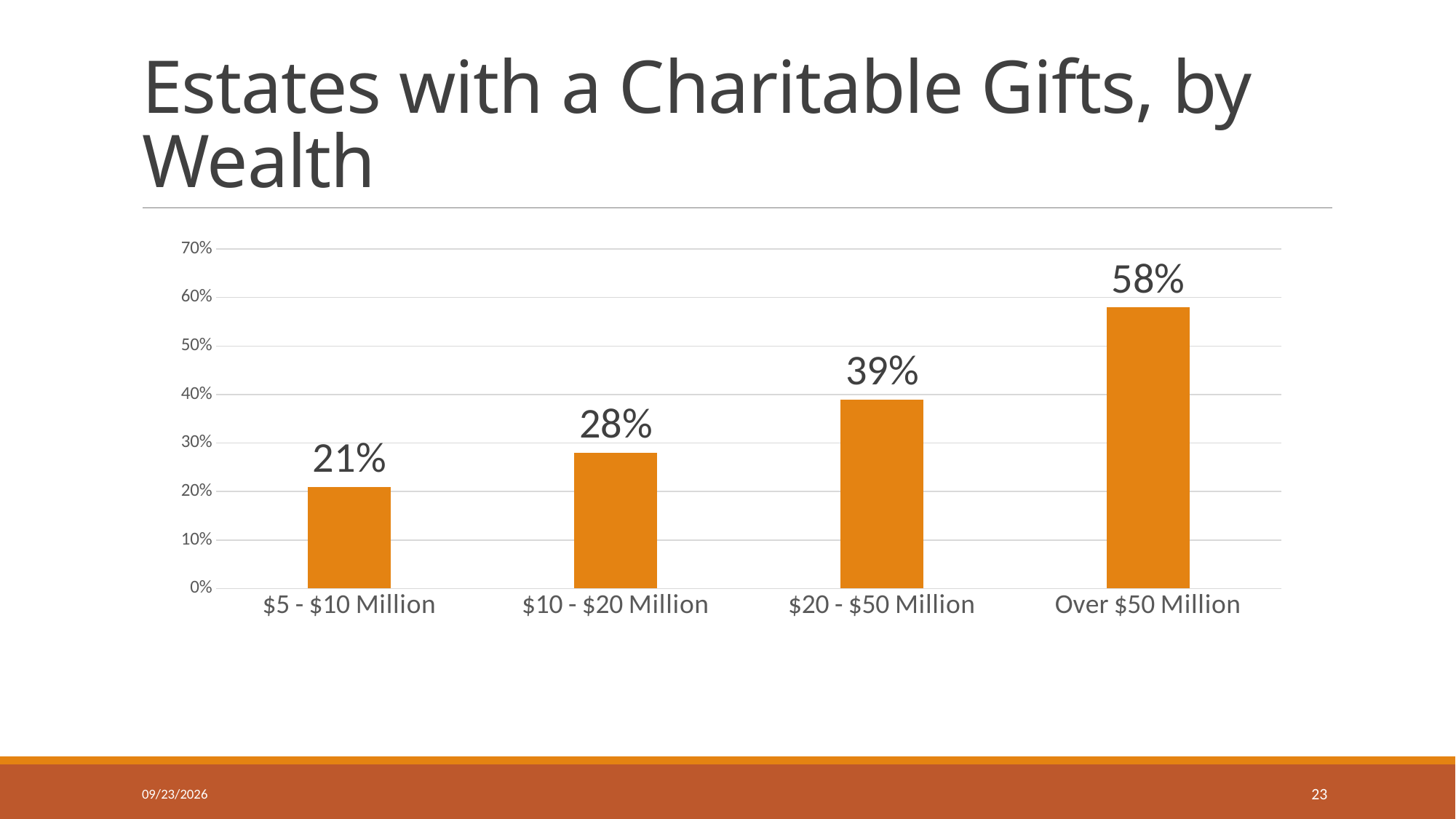
What is the value for Over $50 Million? 58% How many wealth categories are shown on the chart? 4 What is the value for $10 - $20 Million? 28% What is the difference between the values for $20 - $50 Million and $10 - $20 Million? 11% Which is larger, the value for $10 - $20 Million or the value for $20 - $50 Million? $20 - $50 Million Do the values rise or fall as wealth increases along the x axis? Rise What is the difference between the values for Over $50 Million and $5 - $10 Million? 37% What is the value for $20 - $50 Million? 39% What is the value for $5 - $10 Million? 21% What kind of chart is shown on the slide? Bar chart Which wealth category has the lowest value? $5 - $10 Million Which wealth category has the highest value? Over $50 Million